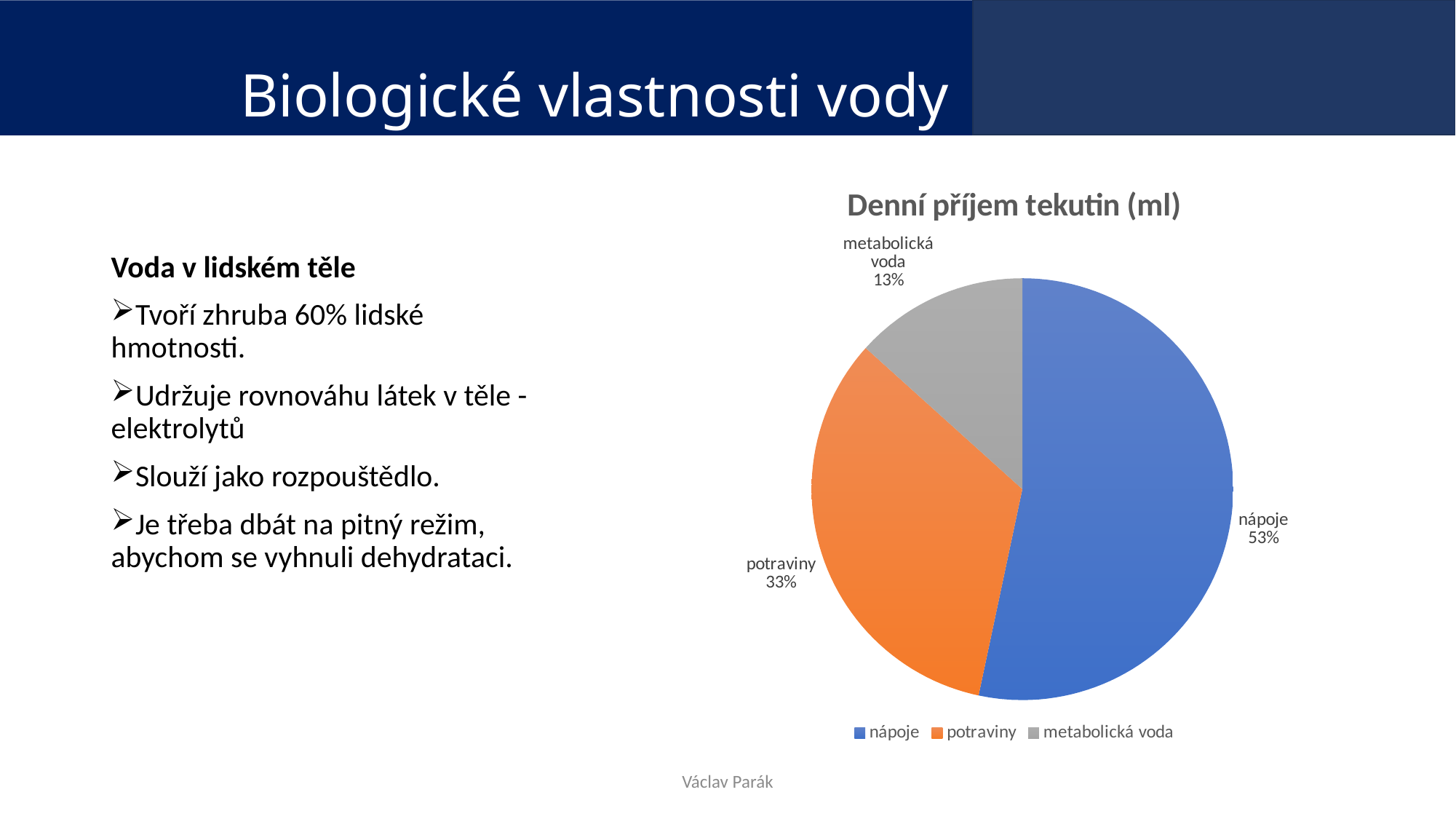
What kind of chart is shown on the slide? pie chart Which category has the largest slice of the pie? nápoje What share of the pie does metabolická voda represent? 13% What colour is the slice for potraviny? orange How many entries does the legend list? 3 Which category has the smallest slice of the pie? metabolická voda What share of the pie does nápoje represent? 53% Which is larger, the share for potraviny or the share for metabolická voda? potraviny What share of the pie does potraviny represent? 33% What is the difference in percentage points between the nápoje share and the potraviny share? 20% How many slices does the pie chart have? 3 What is the title of the chart? Denní příjem tekutin (ml)